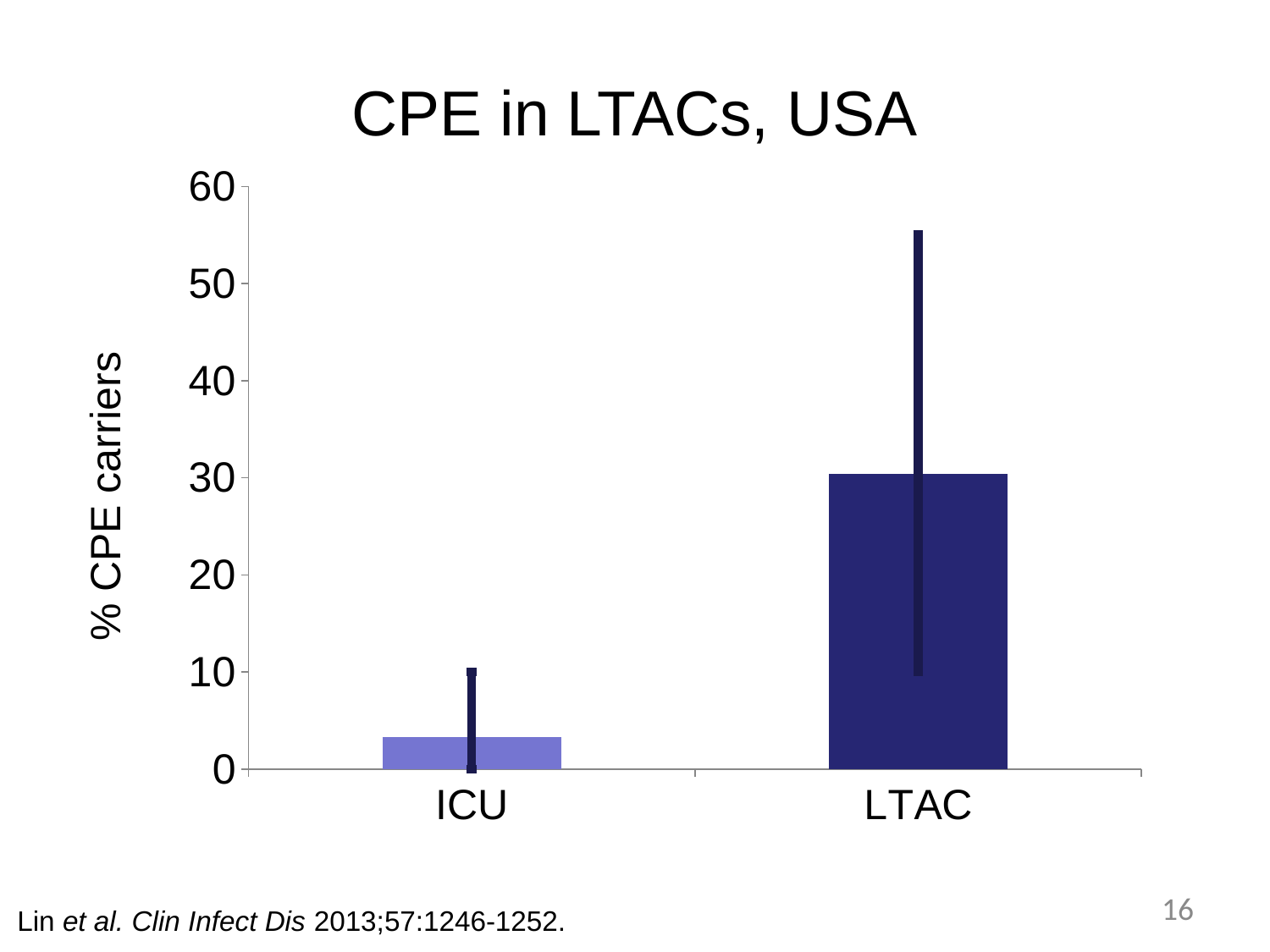
Is the value for ICU greater or less than 10? less How many categories are shown on the x axis? 2 Is the value for LTAC greater or less than 40? less Which category has the highest % CPE carriers? LTAC What is the title of the chart? CPE in LTACs, USA Is the value for LTAC greater or less than 20? greater What type of chart is shown on the slide? bar chart What is the label of the y axis? % CPE carriers Which category has the lowest % CPE carriers? ICU Do the values rise or fall from ICU to LTAC along the x axis? rise Which is larger, the value for ICU or the value for LTAC? LTAC